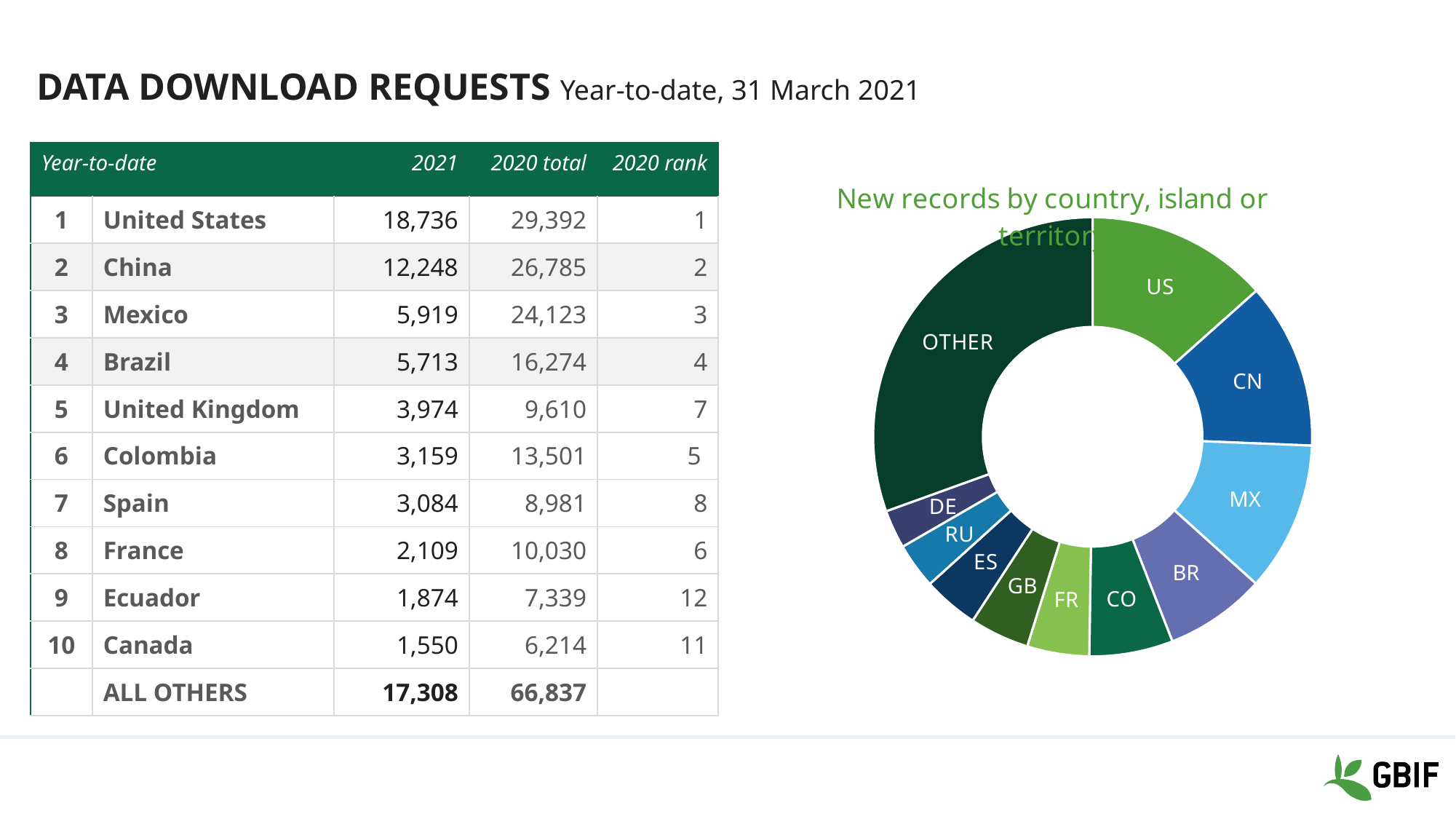
Which segment label appears immediately clockwise after US in the donut chart? CN What is the title of the donut chart? New records by country, island or territory In the donut chart, which segment is larger, CN or DE? CN In the donut chart, which segment is larger, US or GB? US What kind of chart is shown on the right of the slide? Donut chart In the donut chart, which segment is larger, MX or BR? MX Which segment of the donut chart is the largest? OTHER How many segments does the donut chart have? 11